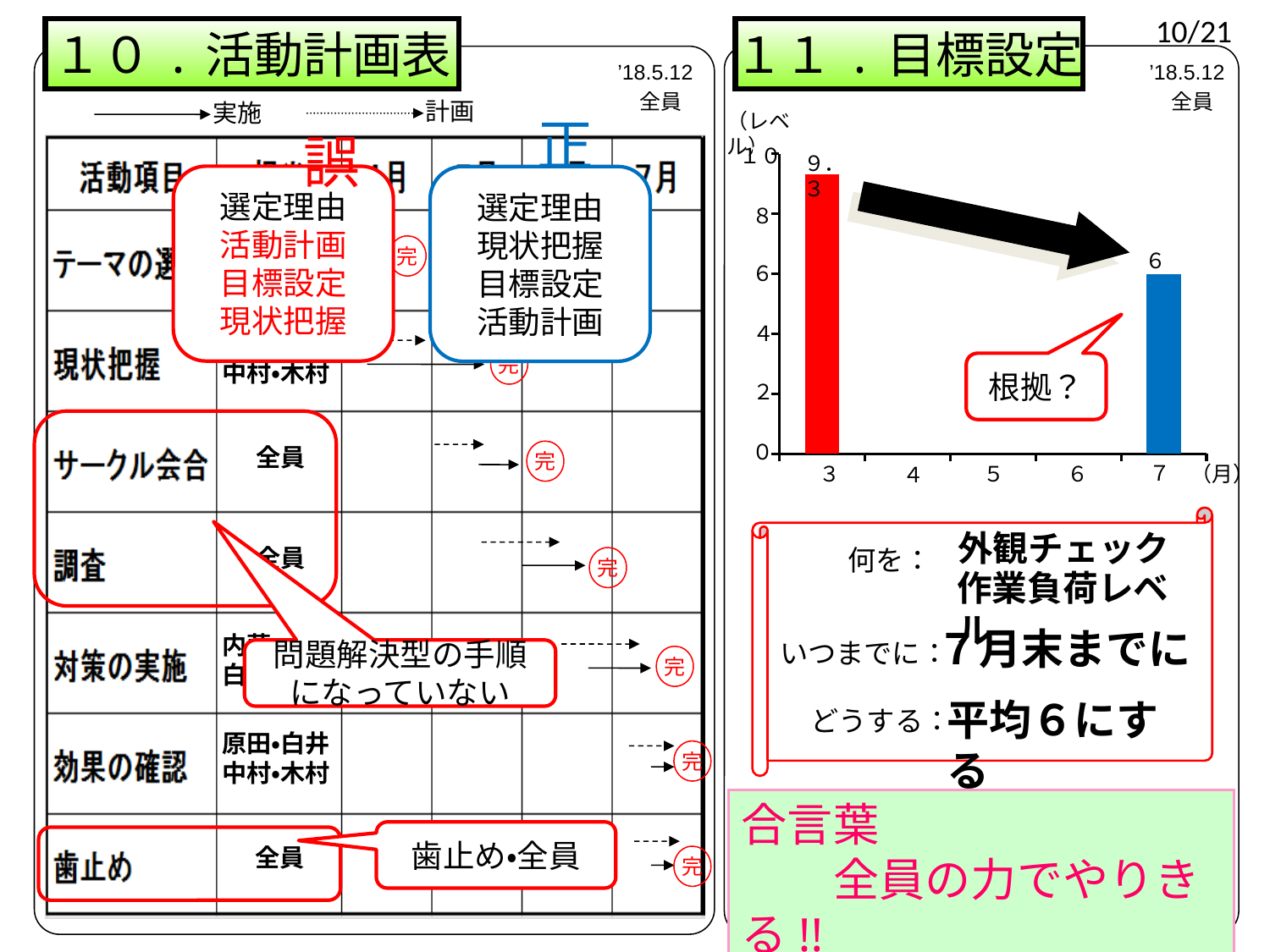
In the 目標設定 chart, which month has the highest bar? 3 How many bars are plotted in the 目標設定 chart? 2 In the 目標設定 chart, is the value for month 3 greater or less than 8? greater In the 目標設定 chart, which is larger, the value for month 3 or the value for month 7? month 3 In the 目標設定 chart, what is the value for month 3? 9.3 In the 目標設定 chart, what is the difference between the values for month 3 and month 7? 3.3 What kind of chart is shown under 目標設定? bar chart In the 目標設定 chart, what colour is the bar for month 7? blue In the 目標設定 chart, is the value for month 7 greater or less than 8? less In the 目標設定 chart, do the values rise or fall from month 3 to month 7? fall In the 目標設定 chart, what is the value for month 7? 6